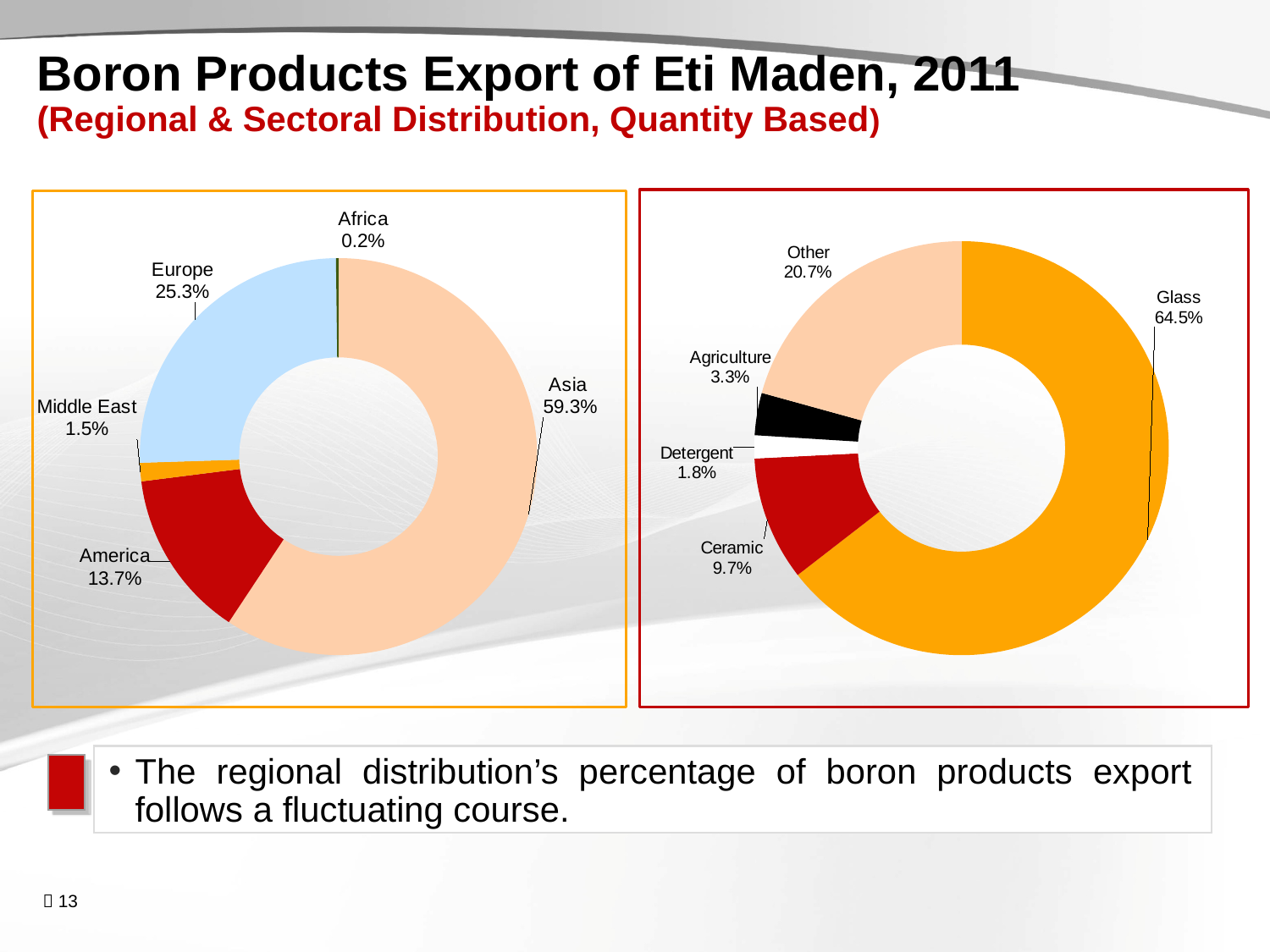
In the left (regional distribution) chart, which region has the largest share? Asia In the left (regional distribution) chart, what is the difference between the shares of Europe and America? 11.6% In the left (regional distribution) chart, what share of exports goes to Europe? 25.3% What type of chart is used on this slide? Pie (doughnut) chart In the left (regional distribution) chart, how many regions are shown? 5 In the left (regional distribution) chart, which region has the smallest share? Africa In the right (sectoral distribution) chart, what share of exports goes to the Ceramic sector? 9.7% In the right (sectoral distribution) chart, which is larger, the share for Agriculture or the share for Ceramic? Ceramic In the right (sectoral distribution) chart, which sector has the smallest share? Detergent In the left (regional distribution) chart, what share of exports goes to Asia? 59.3% In the right (sectoral distribution) chart, what share of exports goes to the Glass sector? 64.5% In the right (sectoral distribution) chart, what is the difference between the shares of Glass and Other? 43.8%